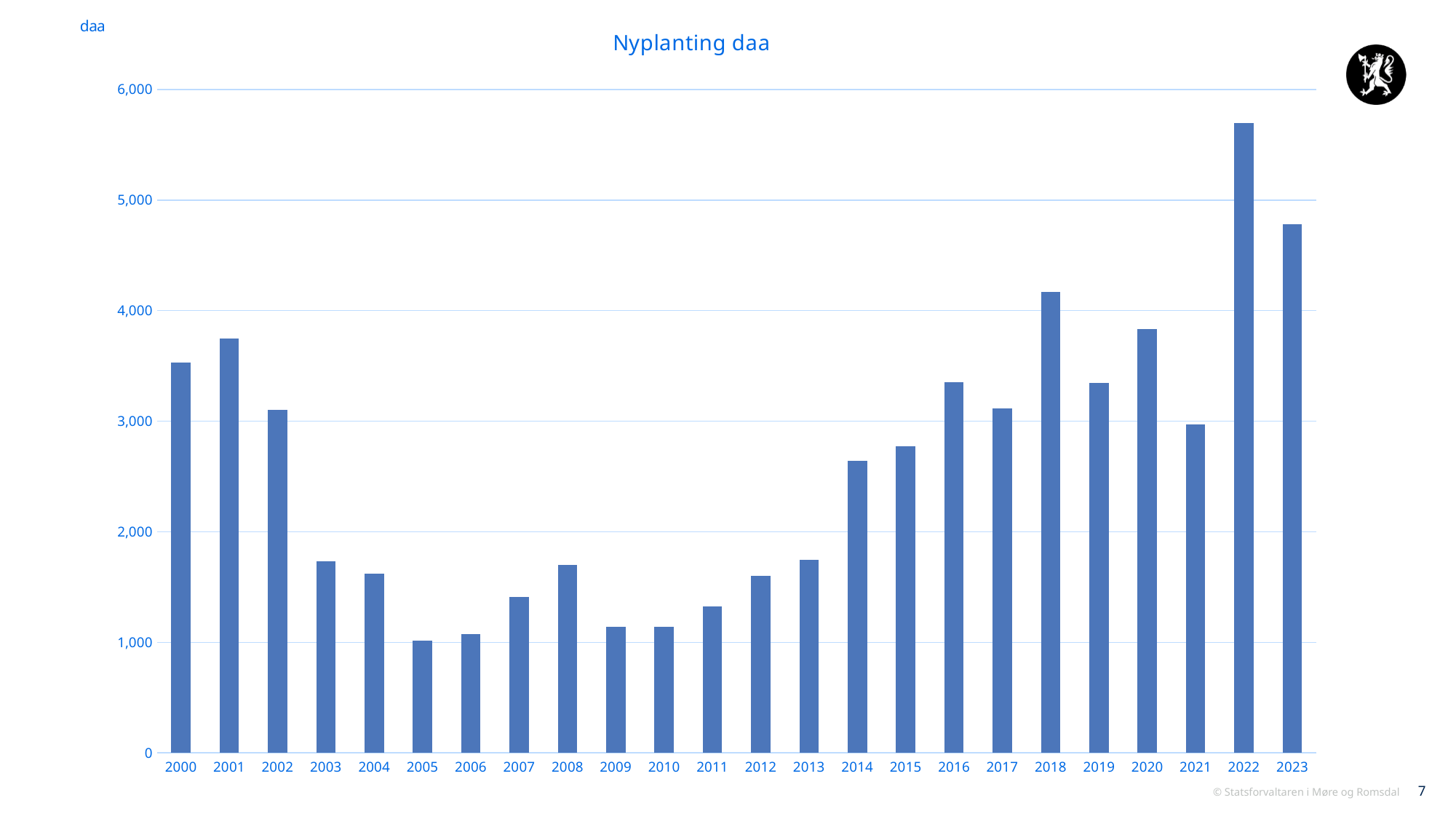
Which year has the highest value? 2022 What is the title of the chart? Nyplanting daa Is the value for 2014 greater or less than 2,000? greater Is the value for 2003 greater or less than 2,000? less How many years are plotted on the x axis? 24 Which is larger, the value for 2000 or the value for 2002? 2000 Is the value for 2018 greater or less than 4,000? greater Do the values rise or fall from 2000 to 2005? fall What kind of chart is shown on the slide? bar chart Which is larger, the value for 2018 or the value for 2020? 2018